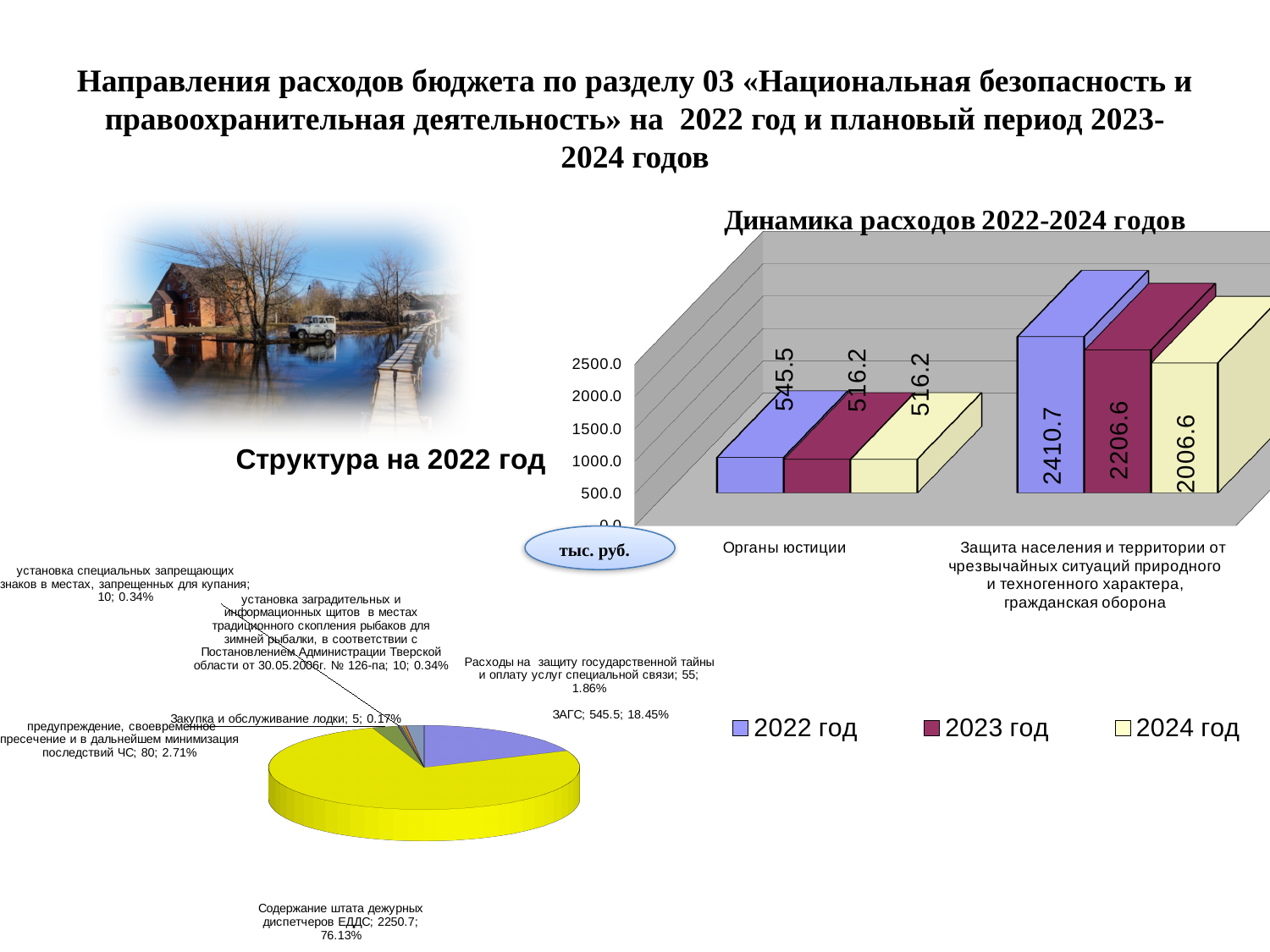
In the chart 'Динамика расходов 2022-2024 годов', what is the difference between the 2022 год and 2024 год values for 'Защита населения и территории от чрезвычайных ситуаций...'? 404.1 In the pie chart 'Структура на 2022 год', what is the value for 'ЗАГС'? 545.5 In the chart 'Динамика расходов 2022-2024 годов', how many series does the legend list? 3 In the pie chart 'Структура на 2022 год', what share does 'Содержание штата дежурных диспетчеров ЕДДС' have? 76.13% In the chart 'Динамика расходов 2022-2024 годов', what is the value for 'Органы юстиции' in the '2022 год' series? 545.5 In the chart 'Динамика расходов 2022-2024 годов', what is the value for 'Защита населения и территории от чрезвычайных ситуаций...' in the '2024 год' series? 2006.6 In the pie chart 'Структура на 2022 год', how many slices are there? 7 What kind of chart is 'Динамика расходов 2022-2024 годов'? bar chart In the chart 'Динамика расходов 2022-2024 годов', which series has the highest value for 'Защита населения и территории от чрезвычайных ситуаций...'? 2022 год In the chart 'Динамика расходов 2022-2024 годов', do the values for 'Защита населения и территории от чрезвычайных ситуаций...' rise or fall from 2022 год to 2024 год? fall In the pie chart 'Структура на 2022 год', which slice is the smallest? Закупка и обслуживание лодки In the chart 'Динамика расходов 2022-2024 годов', what is the value for 'Защита населения и территории от чрезвычайных ситуаций...' in the '2023 год' series? 2206.6